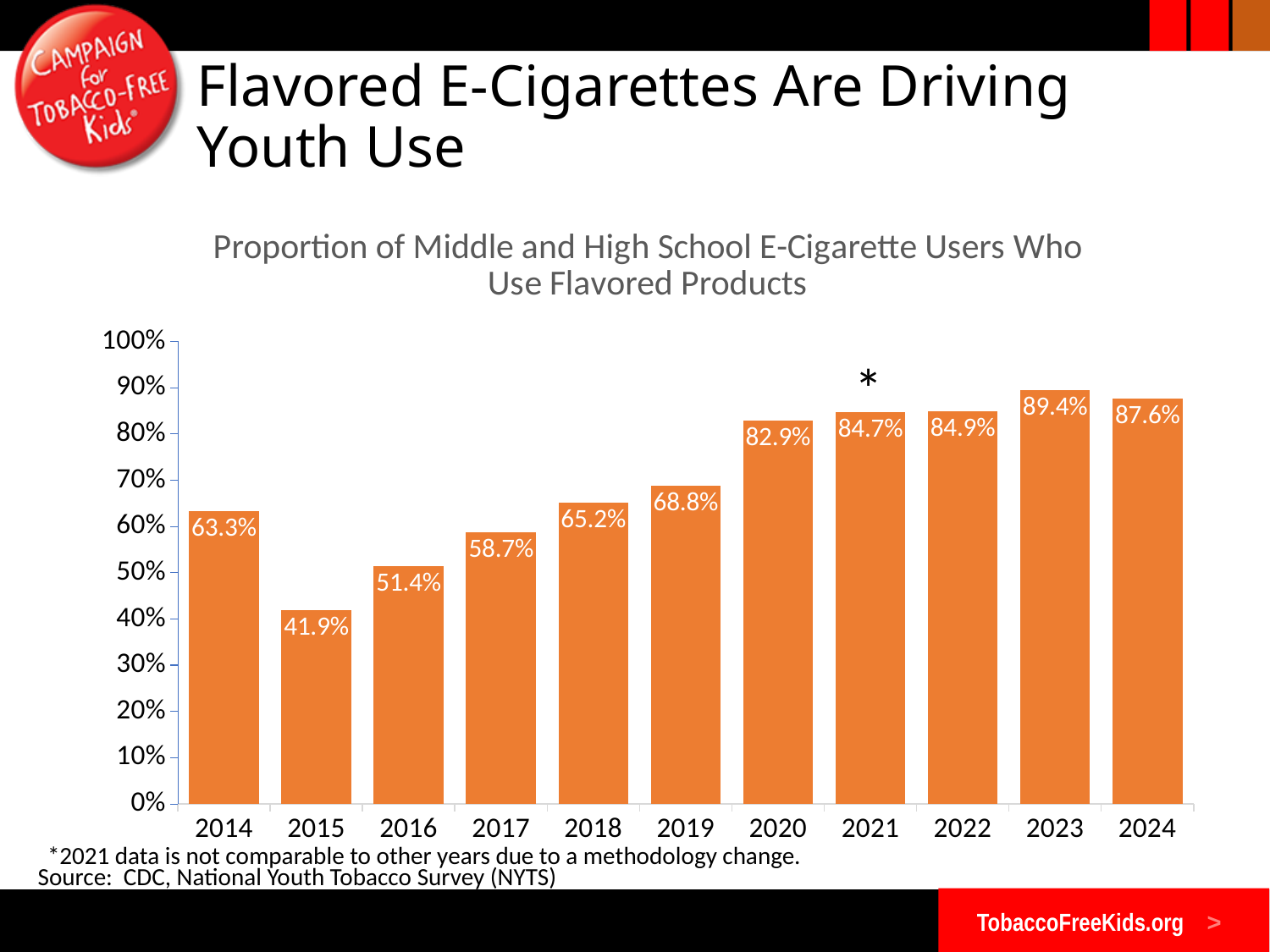
Which year is marked with an asterisk? 2021 Is the value for 2016 greater or less than 60%? less What is the value for 2020? 82.9% What is the value for 2024? 87.6% Which is larger, the value for 2017 or the value for 2019? 2019 What is the difference between the values for 2023 and 2015? 47.5% How many years are shown on the x axis? 11 Which year has the highest value? 2023 Which year has the lowest value? 2015 What is the value for 2014? 63.3% Do the values generally rise or fall from 2015 to 2023? rise What kind of chart is this? bar chart